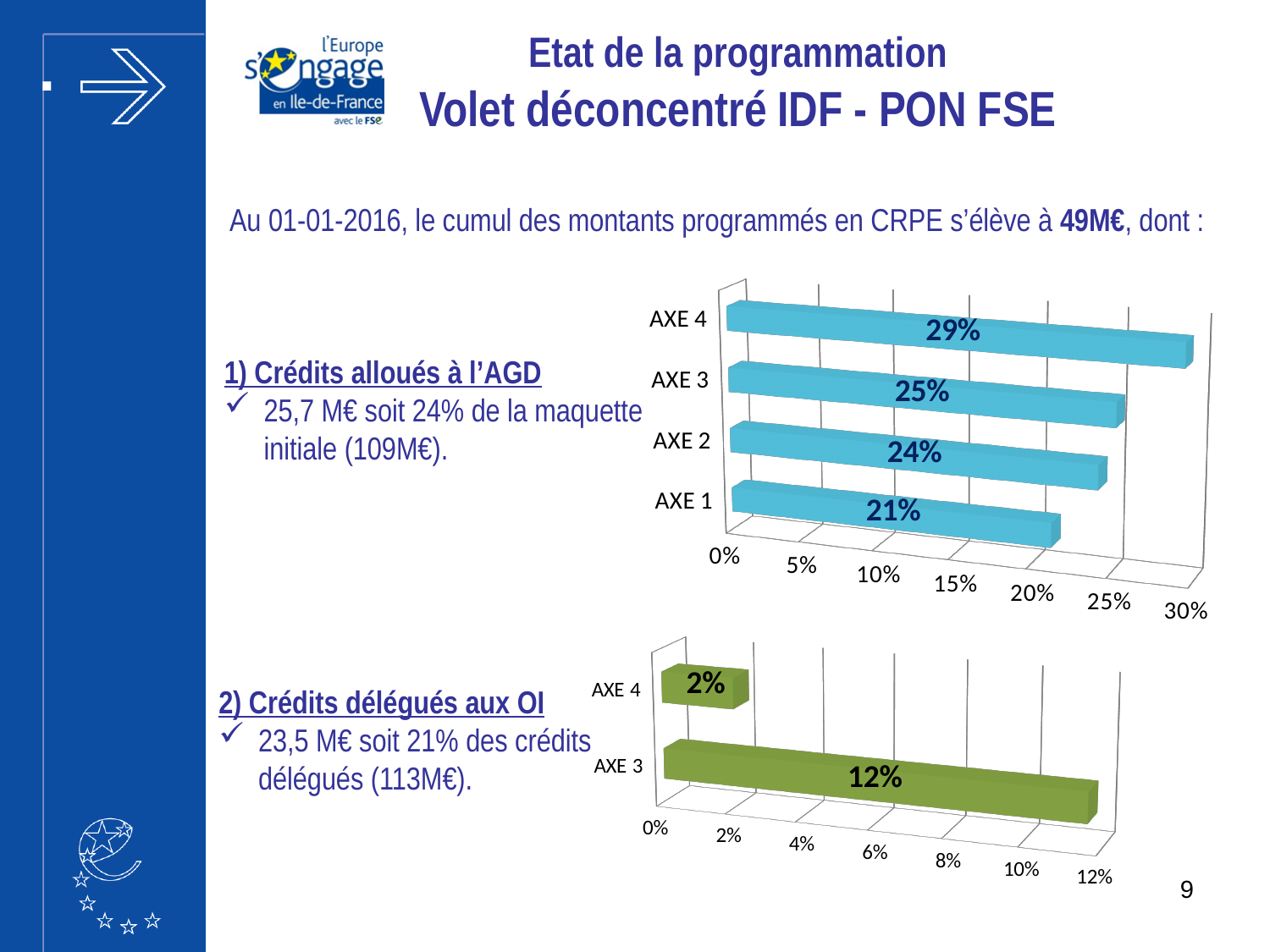
In the upper chart, what is the value for AXE 4? 29% What colour are the bars in the lower chart? Green In the lower chart, what is the value for AXE 4? 2% In the upper chart, which axis has the lowest value? AXE 1 In the upper chart, which axis has the highest value? AXE 4 How many bars are plotted in the upper chart? 4 In the upper chart, what is the value for AXE 1? 21% In the upper chart, which is larger, the value for AXE 3 or the value for AXE 2? AXE 3 What type of chart is the lower chart? Bar chart In the upper chart, what is the difference between the values for AXE 4 and AXE 1? 8% In the lower chart, what is the value for AXE 3? 12% In the lower chart, what is the difference between the values for AXE 3 and AXE 4? 10%